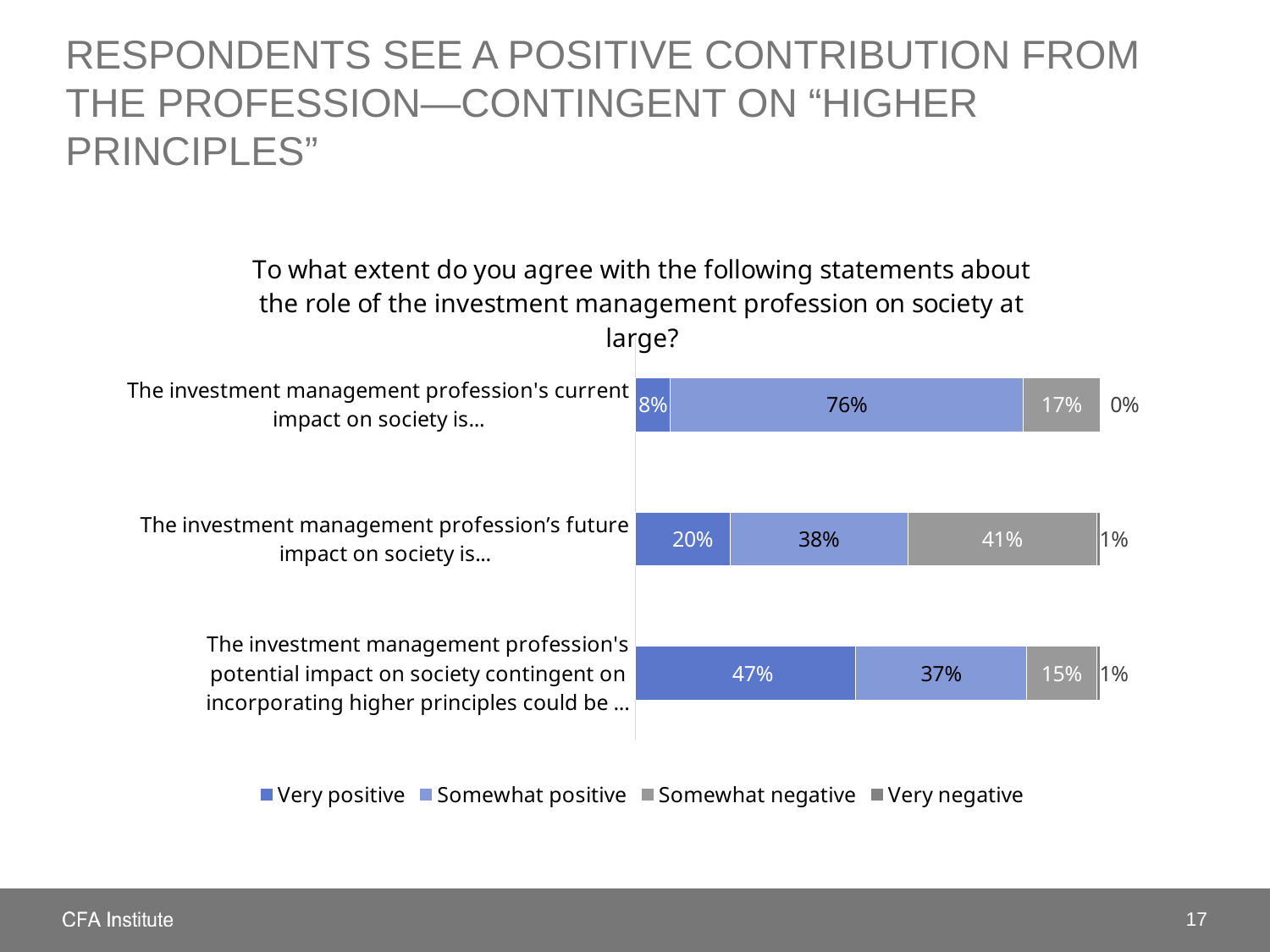
How many series does the legend list? 4 What is the "Very positive" value for "The investment management profession's potential impact on society contingent on incorporating higher principles could be ..."? 47% How many statements (categories) are plotted in the chart? 3 What is the legend entry shown in the darkest blue colour? Very positive Which is larger for the future impact statement: the "Somewhat positive" value or the "Somewhat negative" value? Somewhat negative Which statement has the lowest "Somewhat negative" value? The investment management profession's potential impact on society contingent on incorporating higher principles could be ... What is the difference between the "Very positive" values for the future impact statement and the current impact statement? 12% What is the "Very negative" value for "The investment management profession's current impact on society is..."? 0% Which statement has the highest "Very positive" value? The investment management profession's potential impact on society contingent on incorporating higher principles could be ... What kind of chart is shown on the slide? Stacked bar chart What is the "Somewhat negative" value for "The investment management profession's future impact on society is..."? 41% What is the "Somewhat positive" value for "The investment management profession's current impact on society is..."? 76%